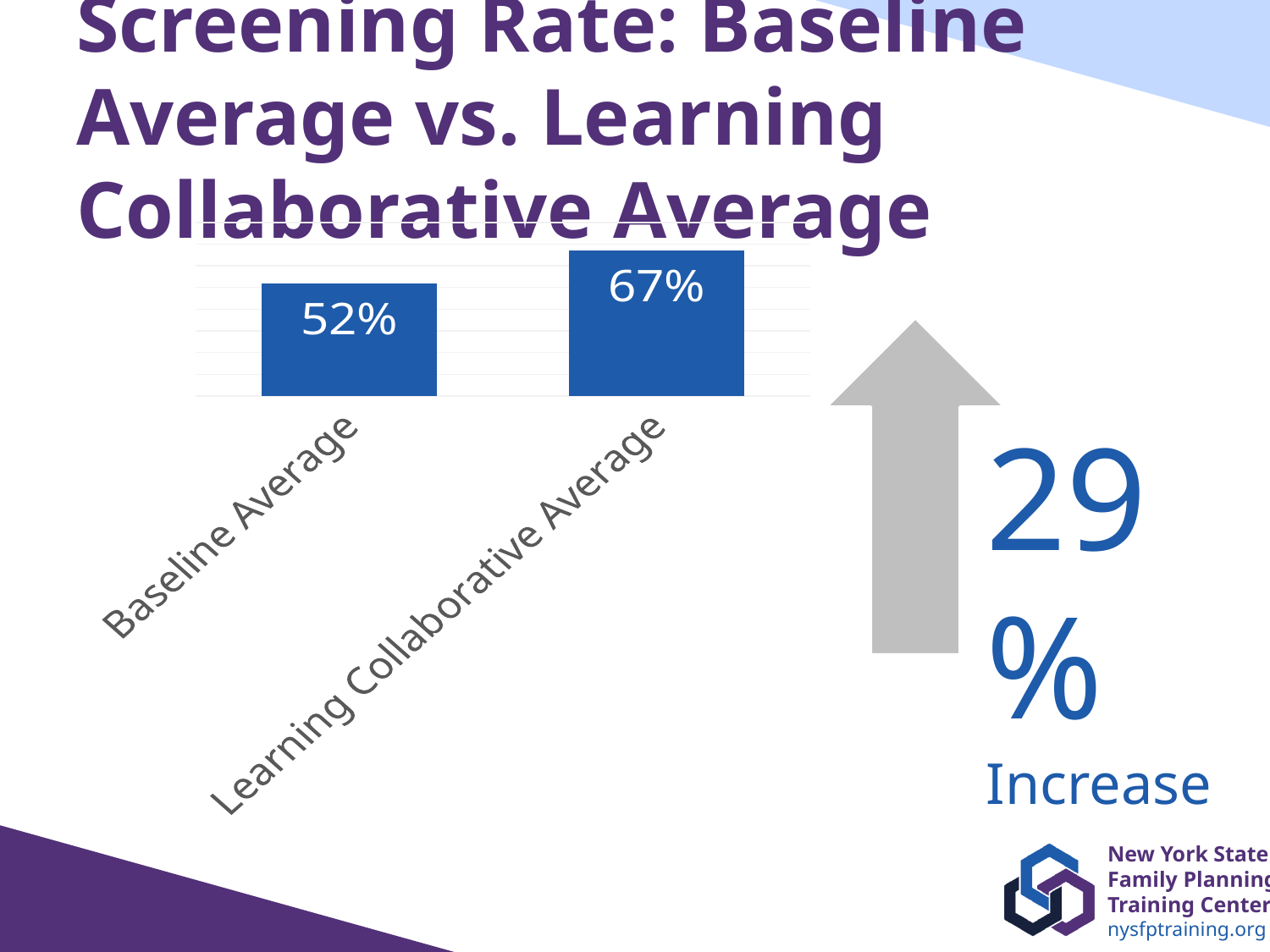
Is the value for Baseline Average larger or smaller than the value for Learning Collaborative Average? smaller What kind of chart is shown on the slide? bar chart Which category has the lower screening rate? Baseline Average What percentage increase is stated next to the arrow on the slide? 29% What is the difference between the Learning Collaborative Average and the Baseline Average? 15 percentage points Do the values rise or fall from Baseline Average to Learning Collaborative Average? rise What colour are the bars in the chart? blue What is the value for Learning Collaborative Average? 67% How many categories are shown in the chart? 2 What is the value for Baseline Average? 52% Which category has the higher screening rate? Learning Collaborative Average